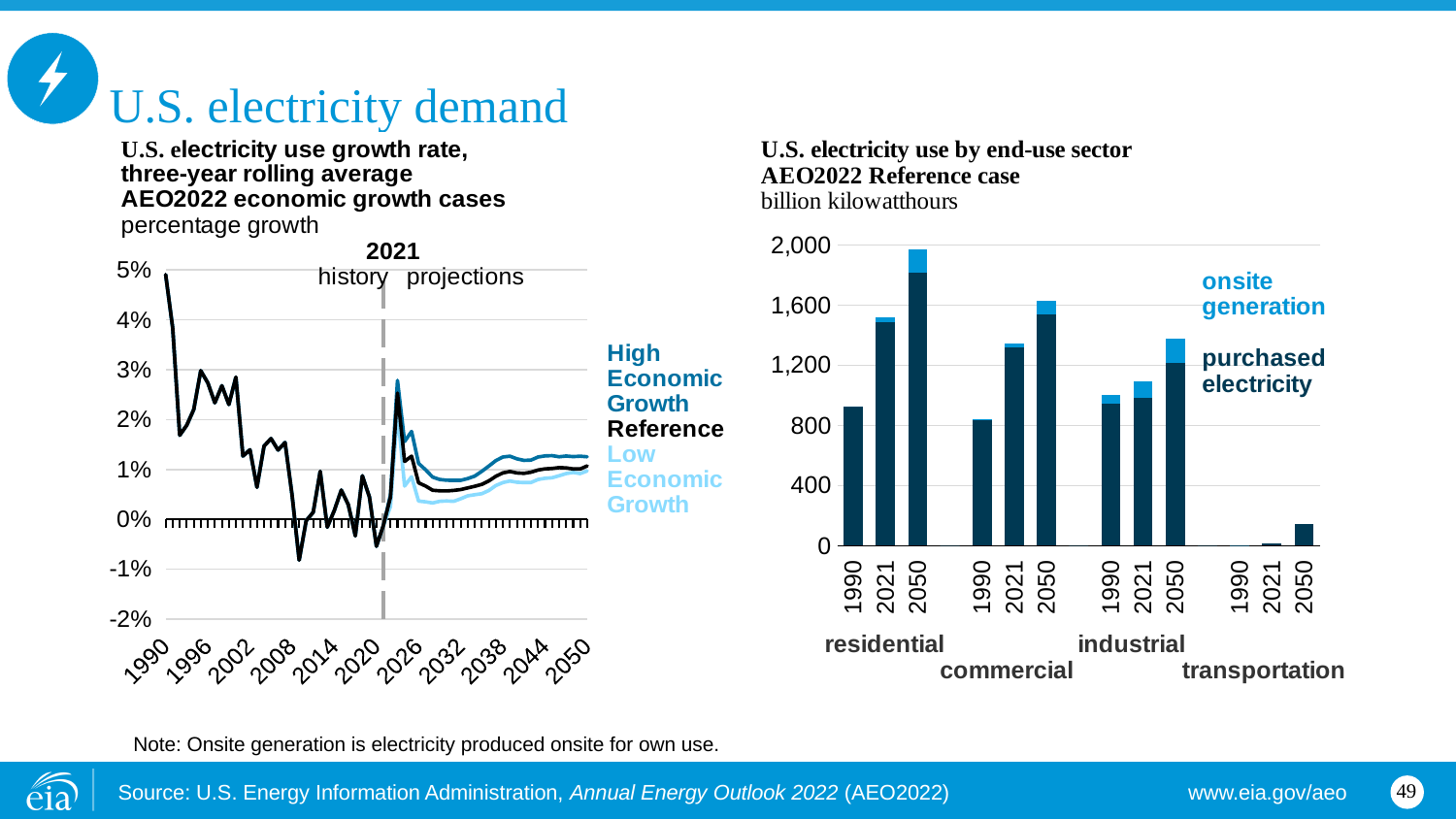
What kind of chart is the chart on the right, titled "U.S. electricity use by end-use sector"? bar chart In the left chart (U.S. electricity use growth rate), what year does the dashed vertical line separating history from projections mark? 2021 In the left chart (U.S. electricity use growth rate), is the growth rate in 1990 greater or less than 4%? greater In the right chart (U.S. electricity use by end-use sector), which is larger in 2021: residential or industrial electricity use? residential In the right chart (U.S. electricity use by end-use sector), how many series does the legend list? 2 In the left chart (U.S. electricity use growth rate), how many economic growth cases are plotted? 3 In the left chart (U.S. electricity use growth rate), does the growth rate generally rise or fall between 1990 and 2020? fall In the right chart (U.S. electricity use by end-use sector), which sector and year has the tallest bar? residential, 2050 What kind of chart is the chart on the left, titled "U.S. electricity use growth rate, three-year rolling average"? line chart In the right chart (U.S. electricity use by end-use sector), is the total for residential in 2050 greater or less than 1,600 billion kilowatthours? greater In the right chart (U.S. electricity use by end-use sector), how many bars are plotted in total? 12 In the right chart (U.S. electricity use by end-use sector), is the total for commercial in 1990 greater or less than 1,200 billion kilowatthours? less